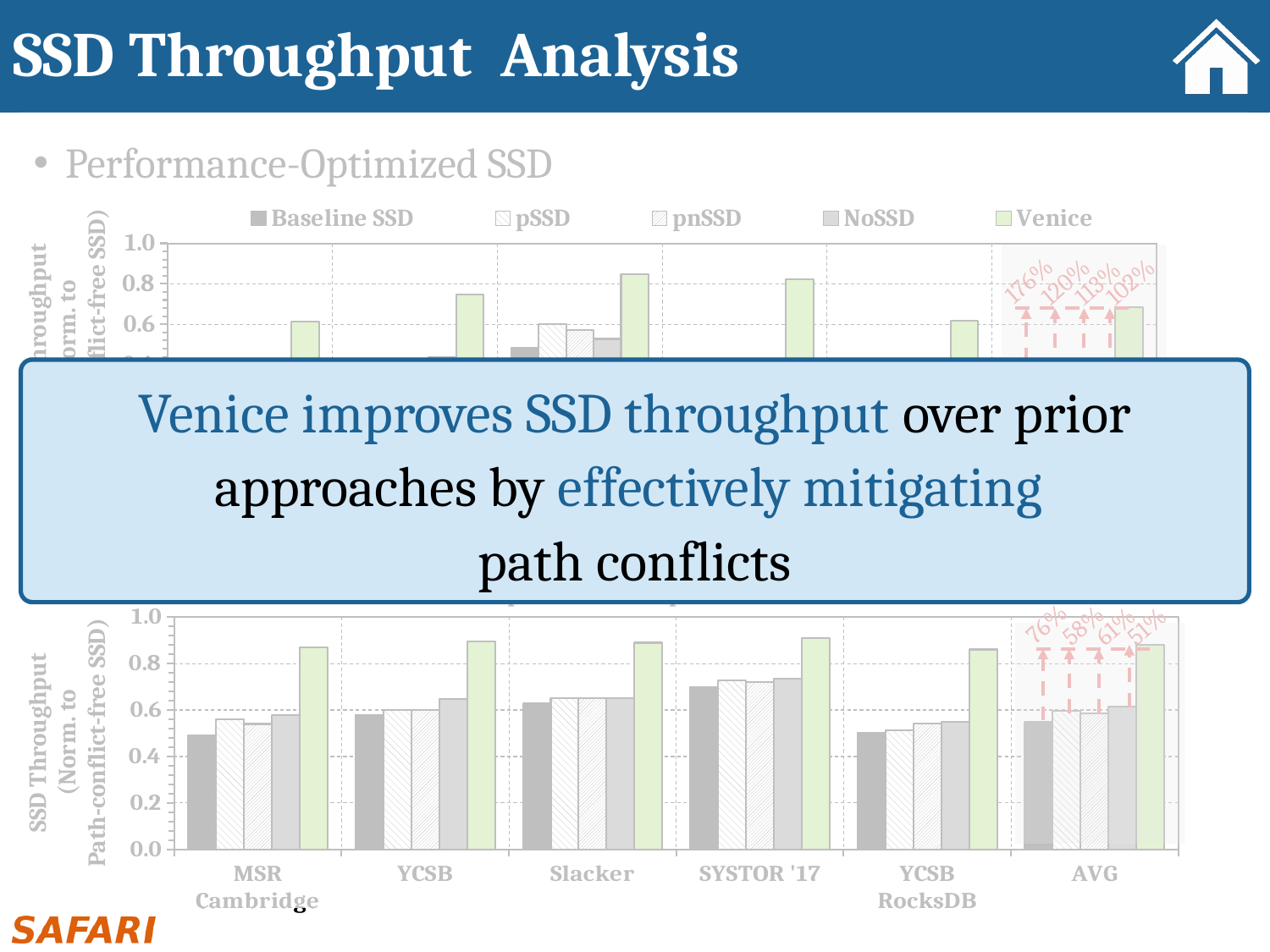
In the bottom chart, is the Venice value for SYSTOR '17 greater or less than 0.8? greater In the bottom chart, is the Venice value for YCSB RocksDB greater or less than 0.8? greater In the bottom chart, for Slacker, which is larger: the Venice bar or the Baseline SSD bar? Venice How many categories are shown on the x axis of the bottom chart? 6 How many series does the legend at the top of the slide list? 5 In the top chart, what is the largest percentage improvement annotated above the rightmost group of bars? 176% In the bottom chart, what is the largest percentage improvement annotated above the AVG bars? 76% In the bottom chart, is the Baseline SSD value for MSR Cambridge greater or less than 0.6? less In the bottom chart, which category has the highest Baseline SSD bar? SYSTOR '17 In the bottom chart, which series has the highest bar in every category? Venice What kind of chart is the bottom chart on the slide? bar chart